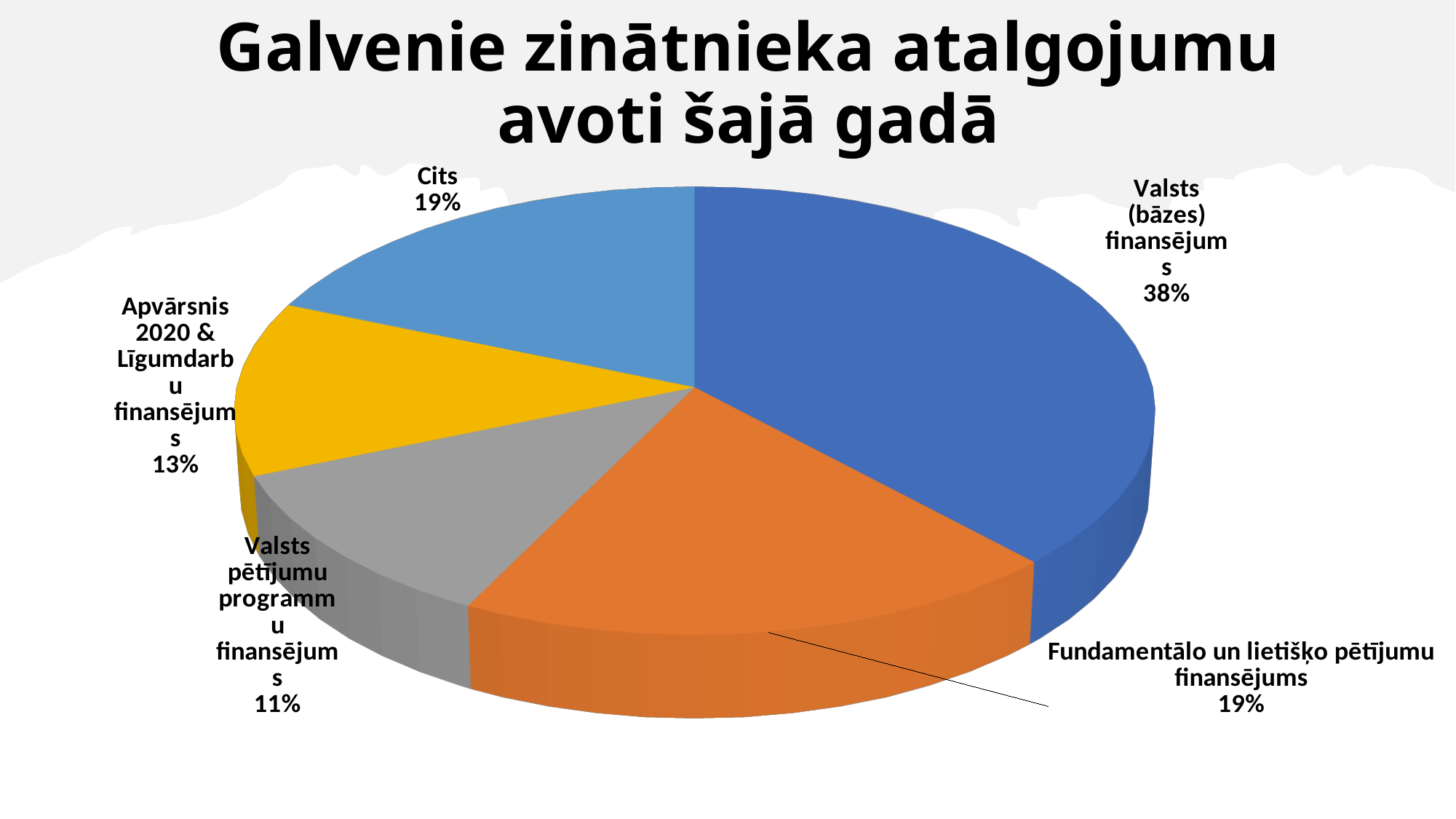
What kind of chart is shown on the slide? Pie chart What share of the pie does Valsts pētījumu programmu finansējums represent? 11% What share of the pie does Apvārsnis 2020 & Līgumdarbu finansējums represent? 13% What is the difference in percentage points between Valsts (bāzes) finansējums and Cits? 19% Which is larger: Apvārsnis 2020 & Līgumdarbu finansējums or Valsts pētījumu programmu finansējums? Apvārsnis 2020 & Līgumdarbu finansējums Which slice of the pie is the largest? Valsts (bāzes) finansējums What share of the pie does Fundamentālo un lietišķo pētījumu finansējums represent? 19% How many slices does the pie chart have? 5 Which slice of the pie is the smallest? Valsts pētījumu programmu finansējums What share of the pie does Valsts (bāzes) finansējums represent? 38% What share of the pie does Cits represent? 19% What is the title of the chart on the slide? Galvenie zinātnieka atalgojumu avoti šajā gadā